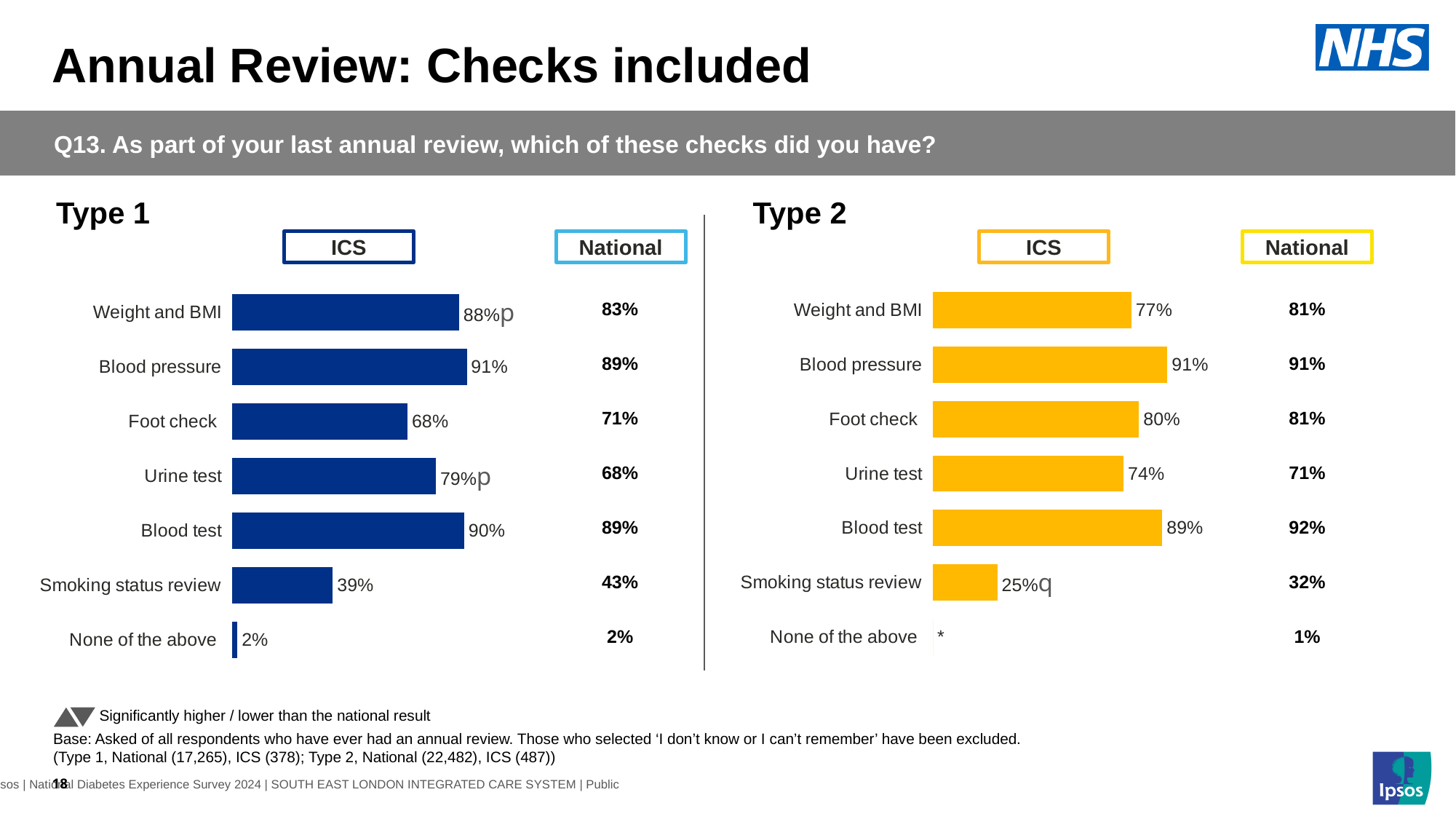
What type of chart is used to show the ICS values in the Type 2 chart? Bar chart In the Type 2 chart, what is the National value for Smoking status review? 32% In the Type 1 chart, what is the difference between the ICS and National values for Urine test? 11 percentage points How many checks are listed in the Type 1 chart? 7 In the Type 1 chart, is the ICS value for Foot check higher or lower than the National value? lower In the Type 1 chart, what is the National value for Urine test? 68% In the Type 2 chart, what is the ICS value for Foot check? 80% In the Type 2 chart, which check has the lowest ICS value among those with a printed percentage? Smoking status review In the Type 2 chart, which is larger for Blood test: the ICS value or the National value? National In the Type 1 chart, what is the ICS value for Blood pressure? 91% In the Type 1 chart, which check has the highest ICS value? Blood pressure In the Type 2 chart, what is the difference between the ICS and National values for Smoking status review? 7 percentage points